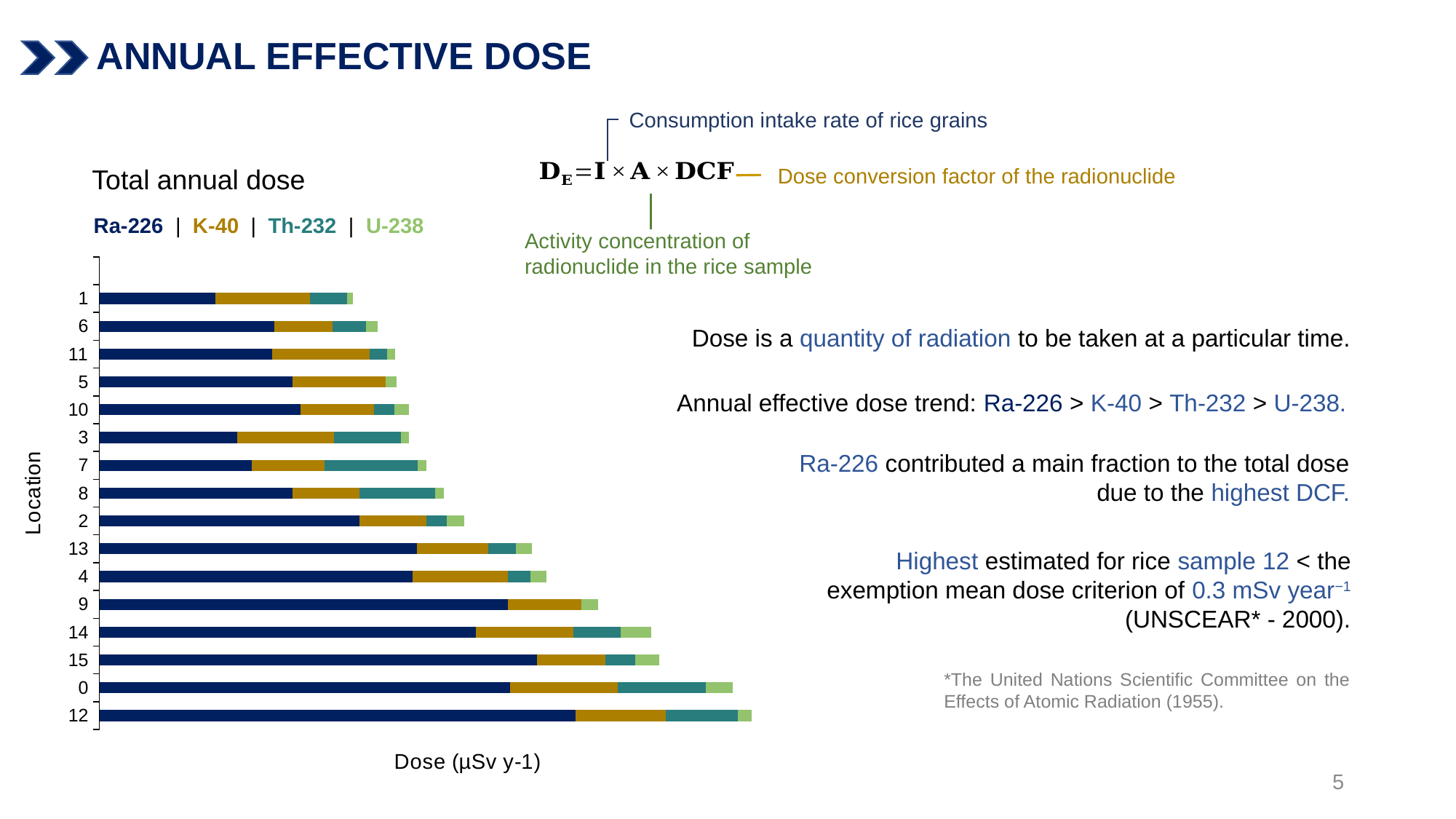
Which has the larger total annual dose, location 0 or location 1? Location 0 Which location has the lowest total annual dose? 1 What is the title of the chart? Total annual dose Which location has the highest total annual dose? 12 Do the total bar lengths increase or decrease going from the top location (1) to the bottom location (12)? Increase What kind of chart is shown on the slide? Stacked bar chart What is the label of the horizontal axis of the chart? Dose (µSv y-1) Which radionuclide contributes the largest segment of the bar for location 12? Ra-226 How many locations are plotted in the chart? 16 Which has the larger total annual dose, location 14 or location 2? Location 14 How many series does the chart legend list? 4 Which radionuclides are listed in the chart legend? Ra-226, K-40, Th-232, U-238